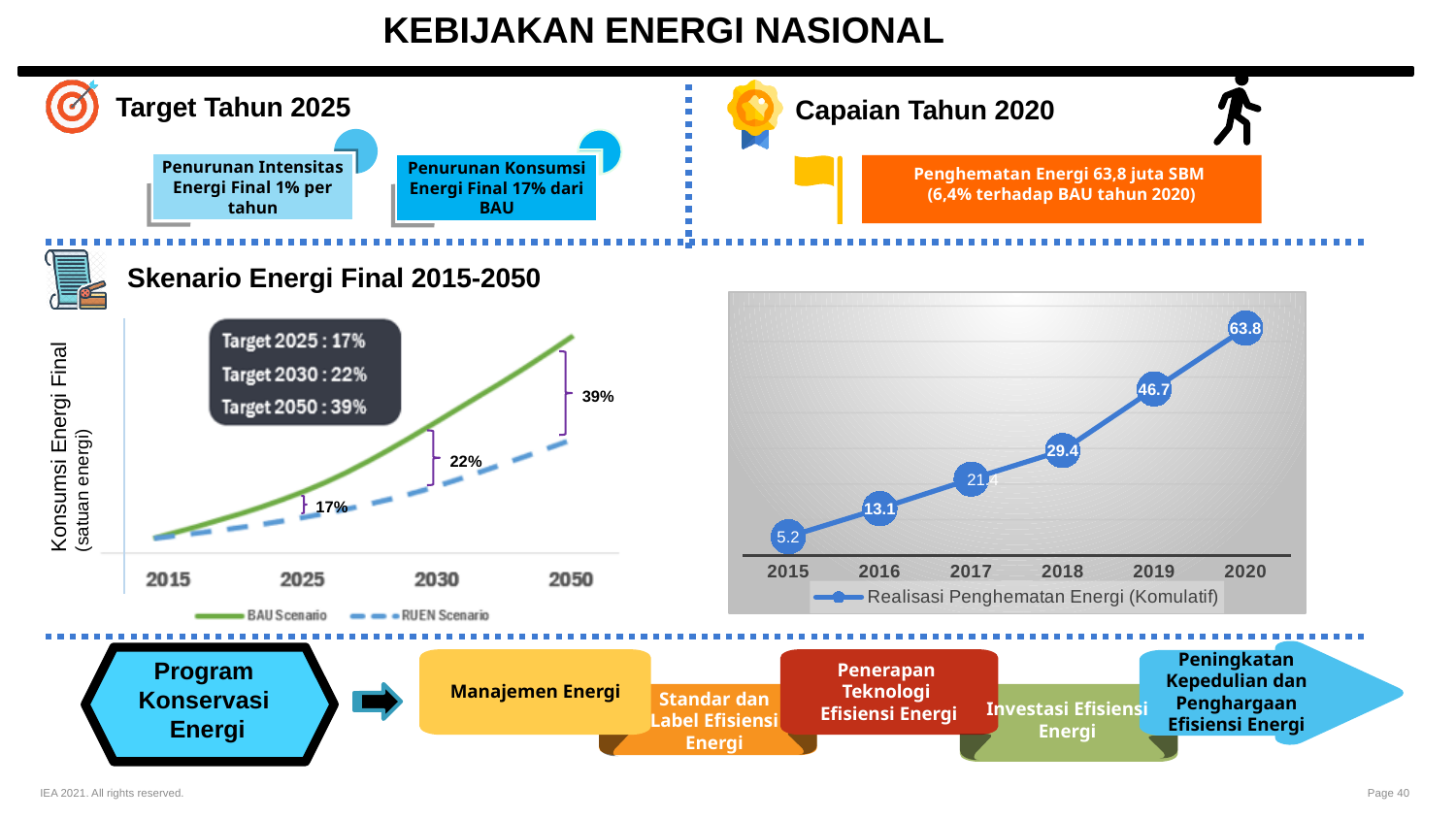
What kind of chart is the right-hand chart (Realisasi Penghematan Energi)? line chart On the right-hand chart (Realisasi Penghematan Energi), which is larger, the value for 2016 or the value for 2017? 2017 On the right-hand chart (Realisasi Penghematan Energi), do the values rise or fall from 2015 to 2020? rise On the right-hand chart (Realisasi Penghematan Energi), which year has the lowest value? 2015 On the right-hand chart (Realisasi Penghematan Energi), what is the value for 2018? 29.4 On the right-hand chart (Realisasi Penghematan Energi), what is the value for 2015? 5.2 On the right-hand chart (Realisasi Penghematan Energi), what is the value for 2020? 63.8 On the right-hand chart (Realisasi Penghematan Energi), what is the value for 2019? 46.7 On the right-hand chart (Realisasi Penghematan Energi), what is the difference between the 2020 value and the 2019 value? 17.1 On the right-hand chart (Realisasi Penghematan Energi), how many years are plotted on the x axis? 6 On the left-hand chart (Skenario Energi Final 2015-2050), how many scenarios does the legend list? 2 On the right-hand chart (Realisasi Penghematan Energi), which year has the highest value? 2020